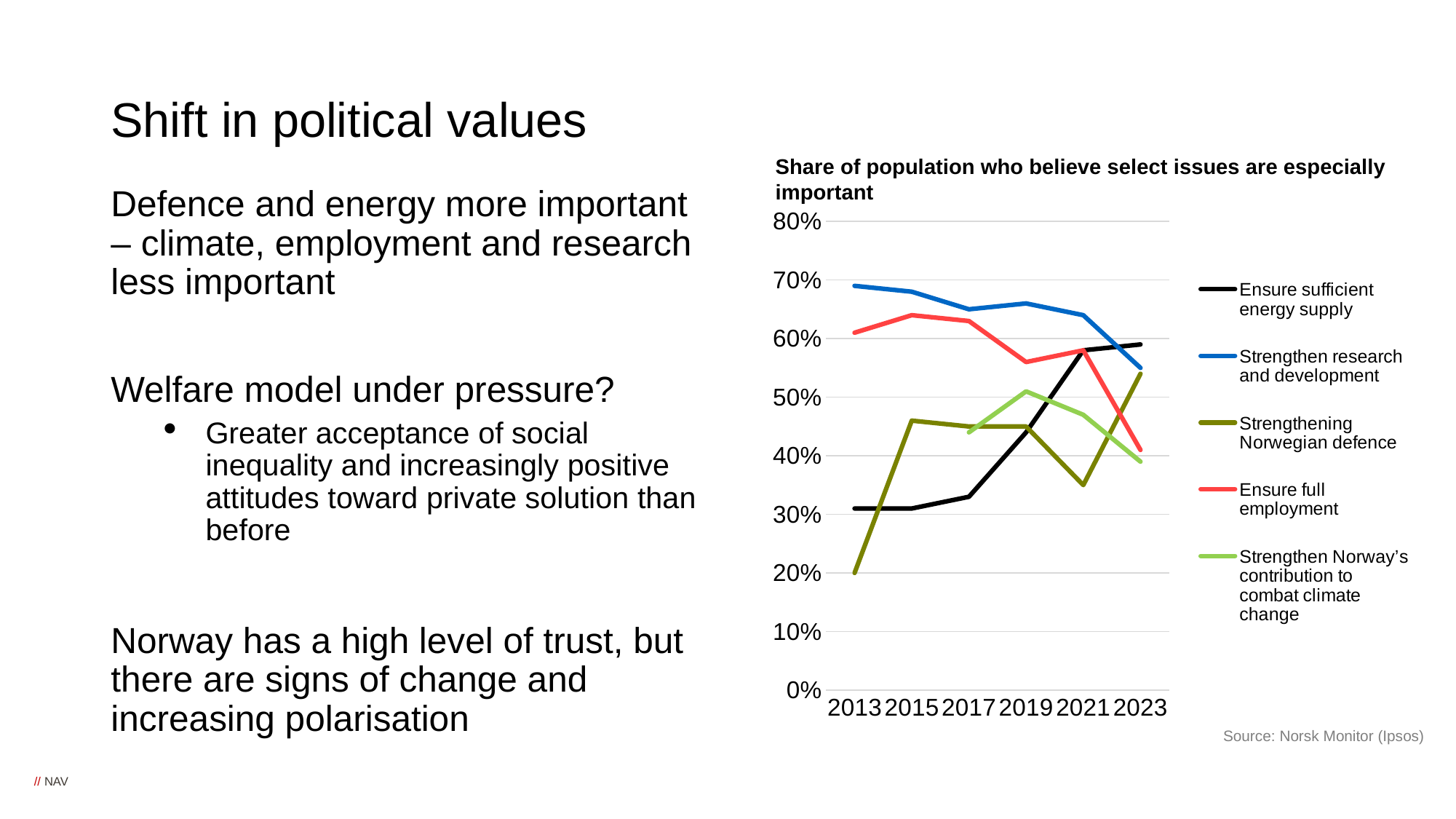
How many years are shown on the x axis of the chart? 6 In 2023, which is larger: 'Ensure sufficient energy supply' or 'Ensure full employment'? Ensure sufficient energy supply What is the title of the chart? Share of population who believe select issues are especially important In 2013, which is larger: 'Strengthen research and development' or 'Ensure sufficient energy supply'? Strengthen research and development Is the value for 'Ensure sufficient energy supply' in 2013 greater or less than 40%? less Is the value for 'Strengthen research and development' in 2013 greater or less than 60%? greater Which series has the lowest value in 2013? Strengthening Norwegian defence How many series does the legend of the chart list? 5 What kind of chart is shown on the slide? line chart Does the line for 'Ensure sufficient energy supply' rise or fall from 2013 to 2023? rise Is the value for 'Strengthening Norwegian defence' in 2013 greater or less than 30%? less